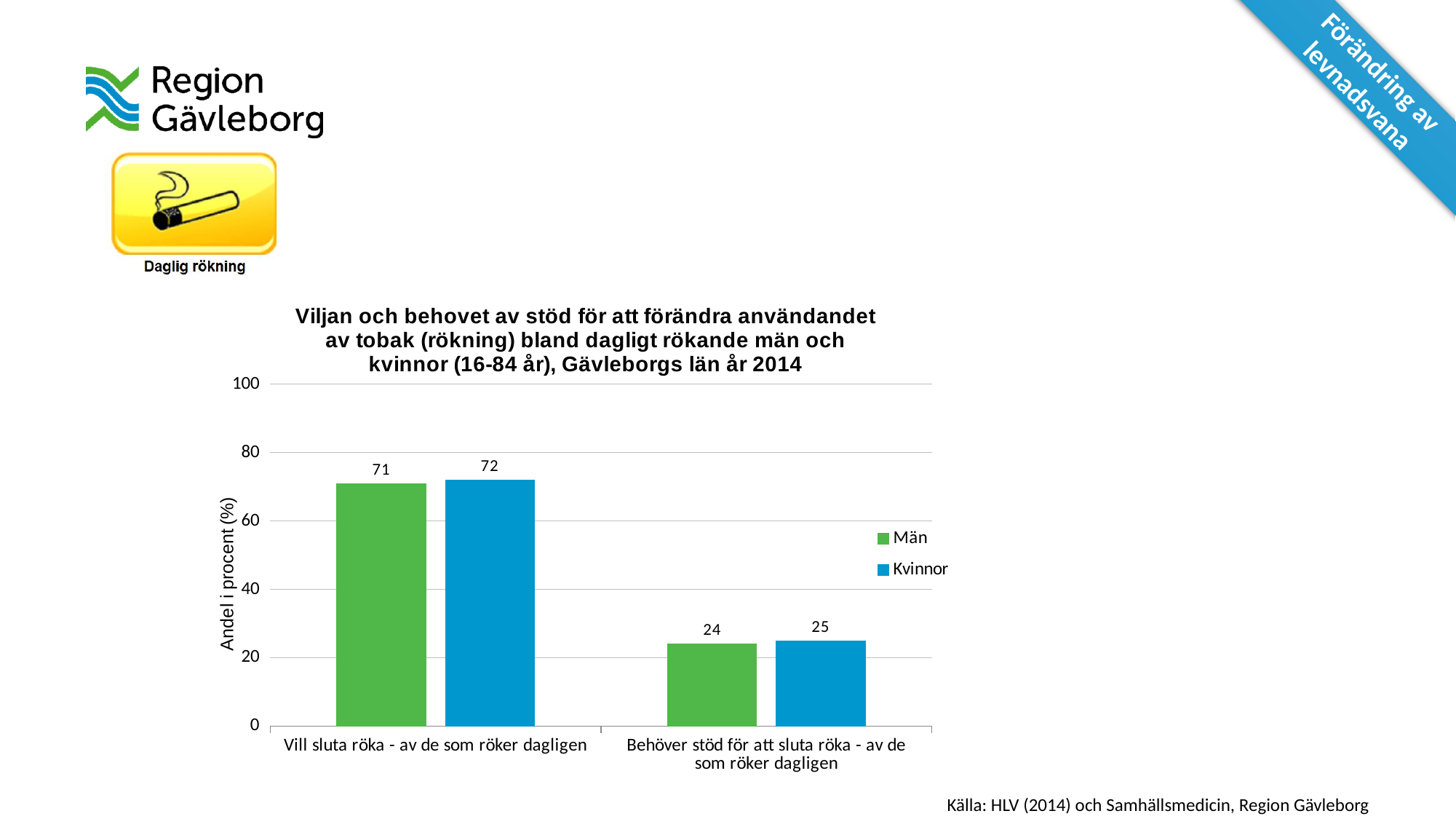
Which category has the highest value for Män? Vill sluta röka - av de som röker dagligen Which category has the lowest value for Kvinnor? Behöver stöd för att sluta röka - av de som röker dagligen How many series does the legend list? 2 Is the value for Kvinnor in 'Behöver stöd för att sluta röka - av de som röker dagligen' greater or less than 40? less What is the value for Män in the category 'Behöver stöd för att sluta röka - av de som röker dagligen'? 24 What is the difference between the Kvinnor and Män values in the category 'Vill sluta röka - av de som röker dagligen'? 1 What is the value for Män in the category 'Vill sluta röka - av de som röker dagligen'? 71 What is the value for Kvinnor in the category 'Vill sluta röka - av de som röker dagligen'? 72 What is the difference between the Män values for 'Vill sluta röka' and 'Behöver stöd för att sluta röka'? 47 How many categories are shown on the x axis? 2 What is the value for Kvinnor in the category 'Behöver stöd för att sluta röka - av de som röker dagligen'? 25 What kind of chart is shown on the slide? bar chart